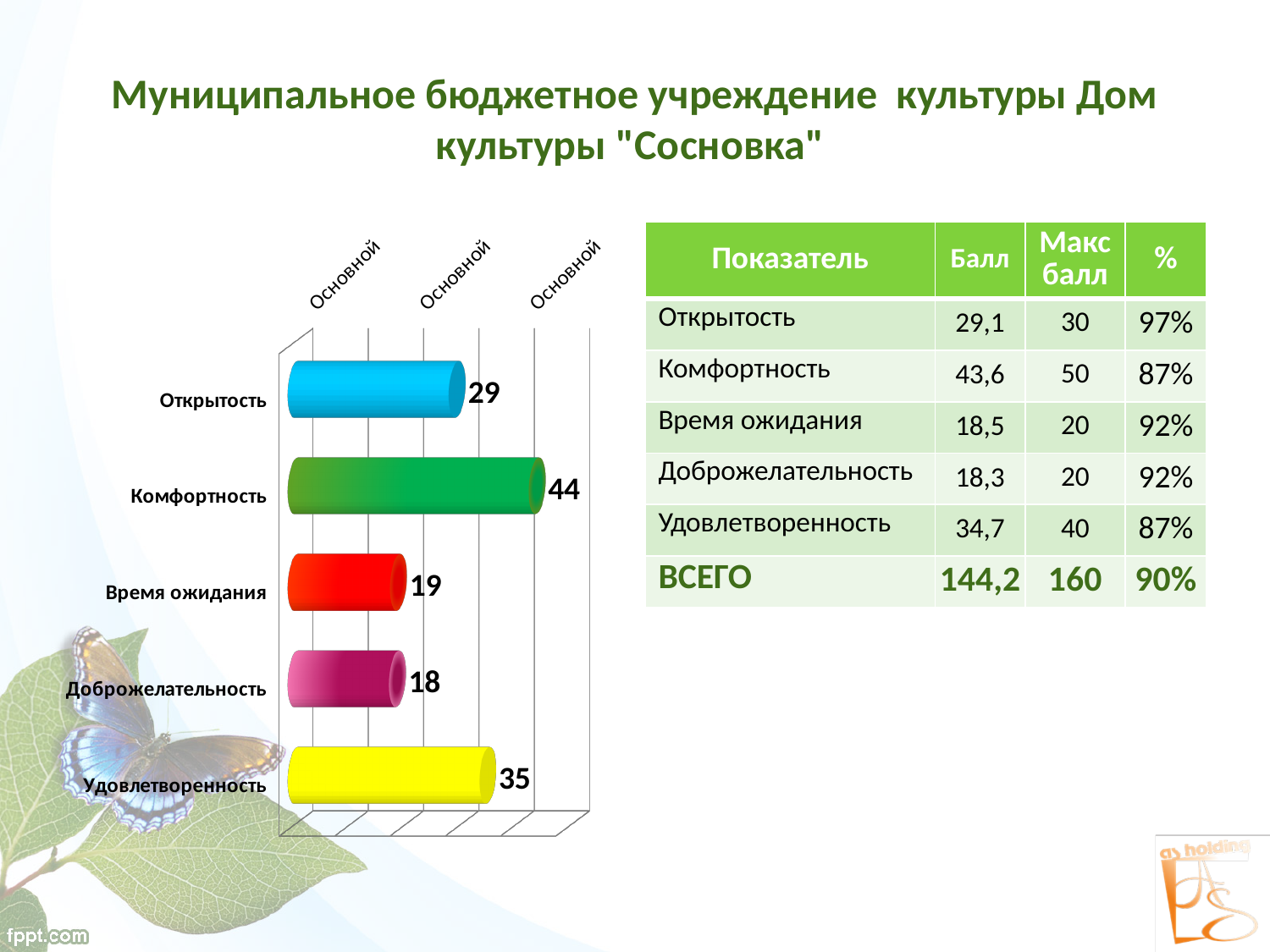
What colour is the bar for Время ожидания in the chart? Red How many categories are plotted in the chart? 5 What value does the chart show for Комфортность? 44 What is the difference between the values for Комфортность and Удовлетворенность in the chart? 9 What kind of chart is shown on the slide? Bar chart Which is larger in the chart, the value for Открытость or the value for Удовлетворенность? Удовлетворенность What value does the chart show for Открытость? 29 Which category has the lowest value in the chart? Доброжелательность What value does the chart show for Доброжелательность? 18 What value does the chart show for Удовлетворенность? 35 Which category has the highest value in the chart? Комфортность What is the difference between the values for Открытость and Время ожидания in the chart? 10